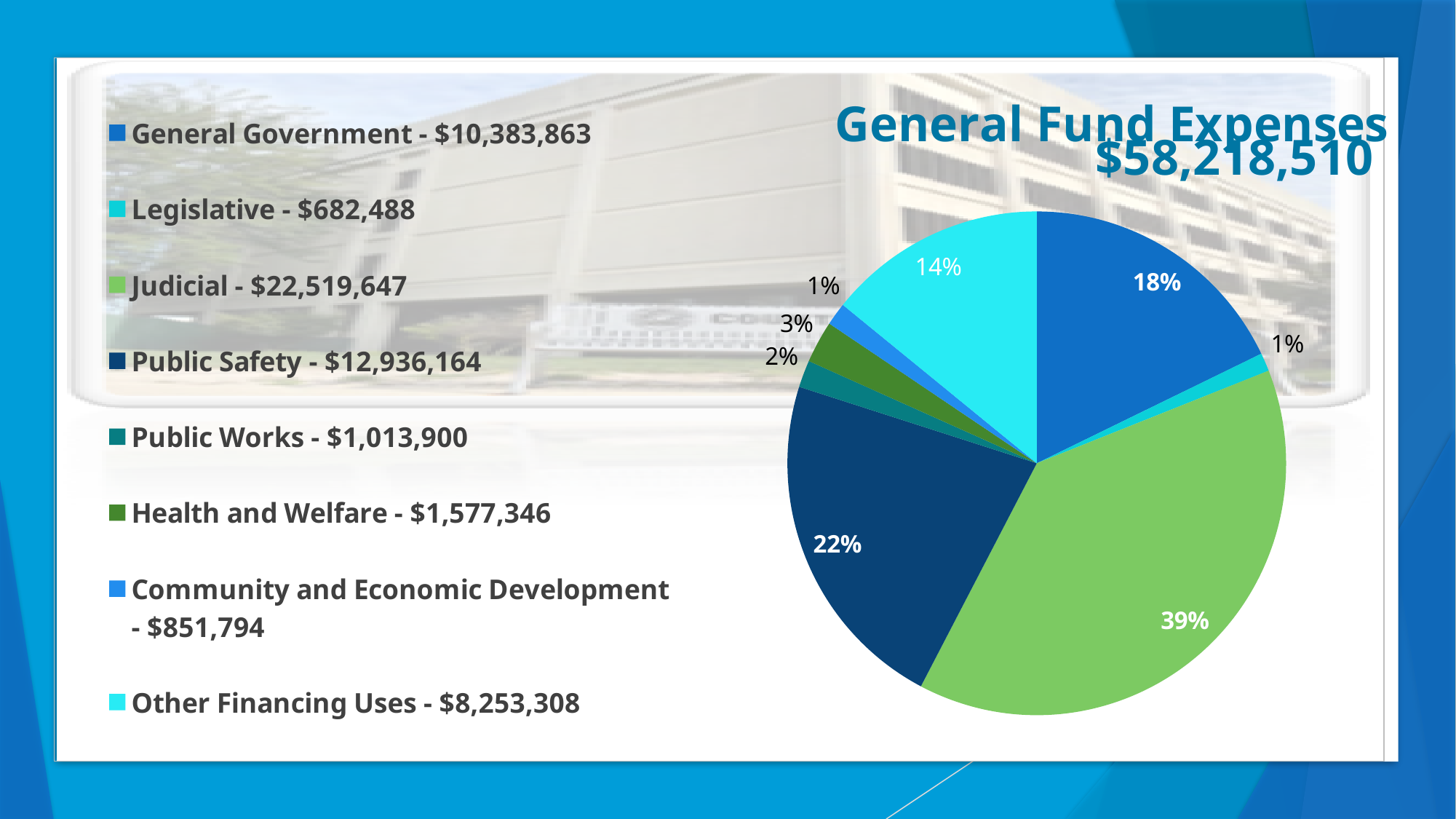
What kind of chart is shown on the slide? Pie chart What share of the pie does Judicial represent? 39% What is the title of the chart? General Fund Expenses $58,218,510 Which category has the largest share of General Fund Expenses? Judicial What share of the pie does Other Financing Uses represent? 14% What is the dollar amount for General Government? $10,383,863 Which category has the smallest dollar amount in the legend? Legislative What share of the pie does Public Safety represent? 22% Which is larger, General Government or Other Financing Uses? General Government How many categories does the pie chart have? 8 What is the dollar amount for Health and Welfare? $1,577,346 What is the difference between the Judicial and Public Safety amounts? $9,583,483